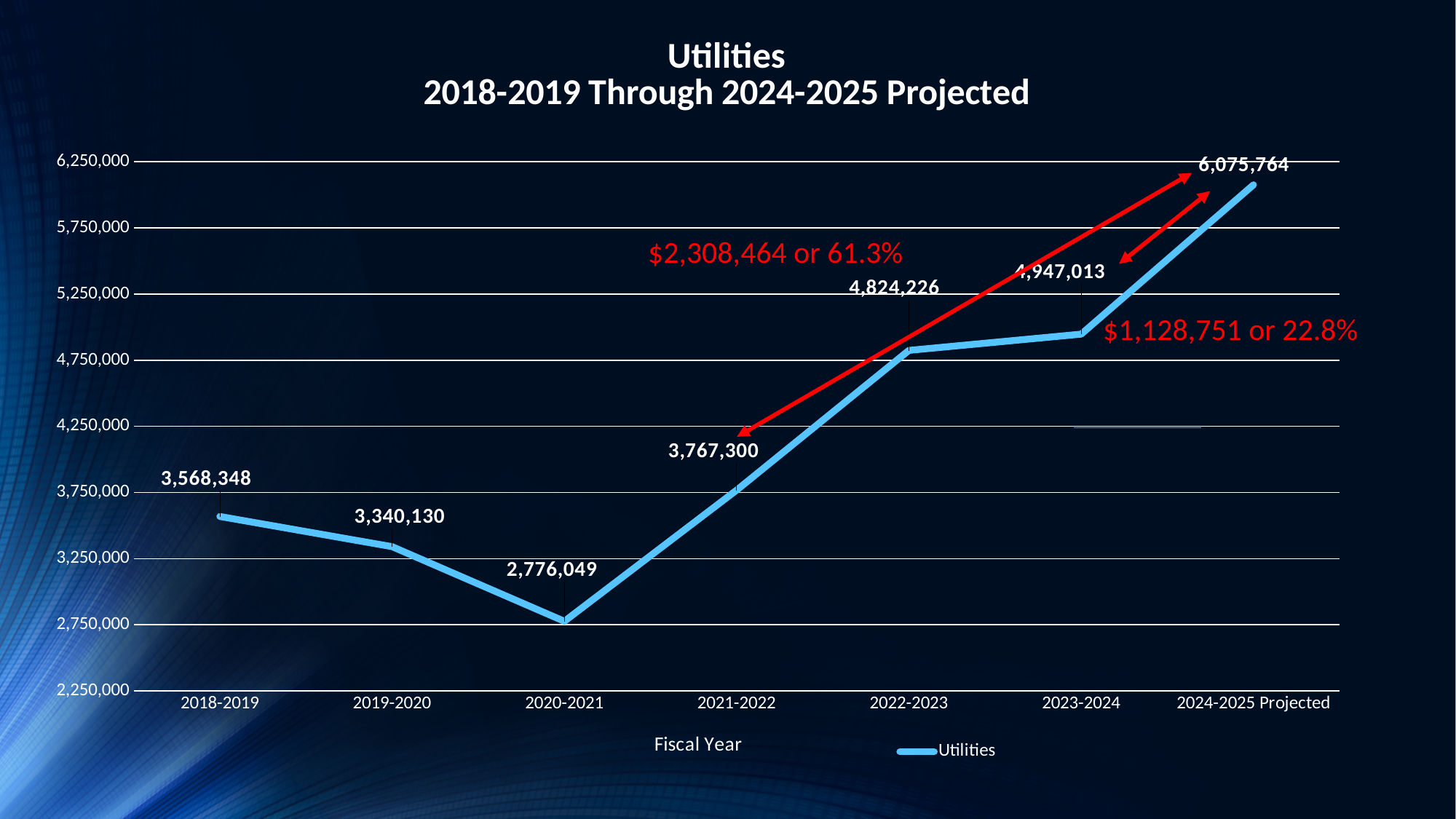
What is the Utilities value for 2020-2021? 2,776,049 What is the Utilities value for 2022-2023? 4,824,226 Do the Utilities values rise or fall from 2020-2021 to 2024-2025 Projected? Rise Which fiscal year has the lowest Utilities value? 2020-2021 How many fiscal years are plotted on the chart? 7 What type of chart is shown on the slide? Line chart Which fiscal year has the highest Utilities value? 2024-2025 Projected What is the difference between the Utilities values for 2024-2025 Projected and 2023-2024? 1,128,751 What is the difference between the Utilities values for 2018-2019 and 2019-2020? 228,218 How many series does the legend list? 1 What is the projected Utilities value for 2024-2025? 6,075,764 Which is larger, the Utilities value for 2018-2019 or for 2021-2022? 2021-2022